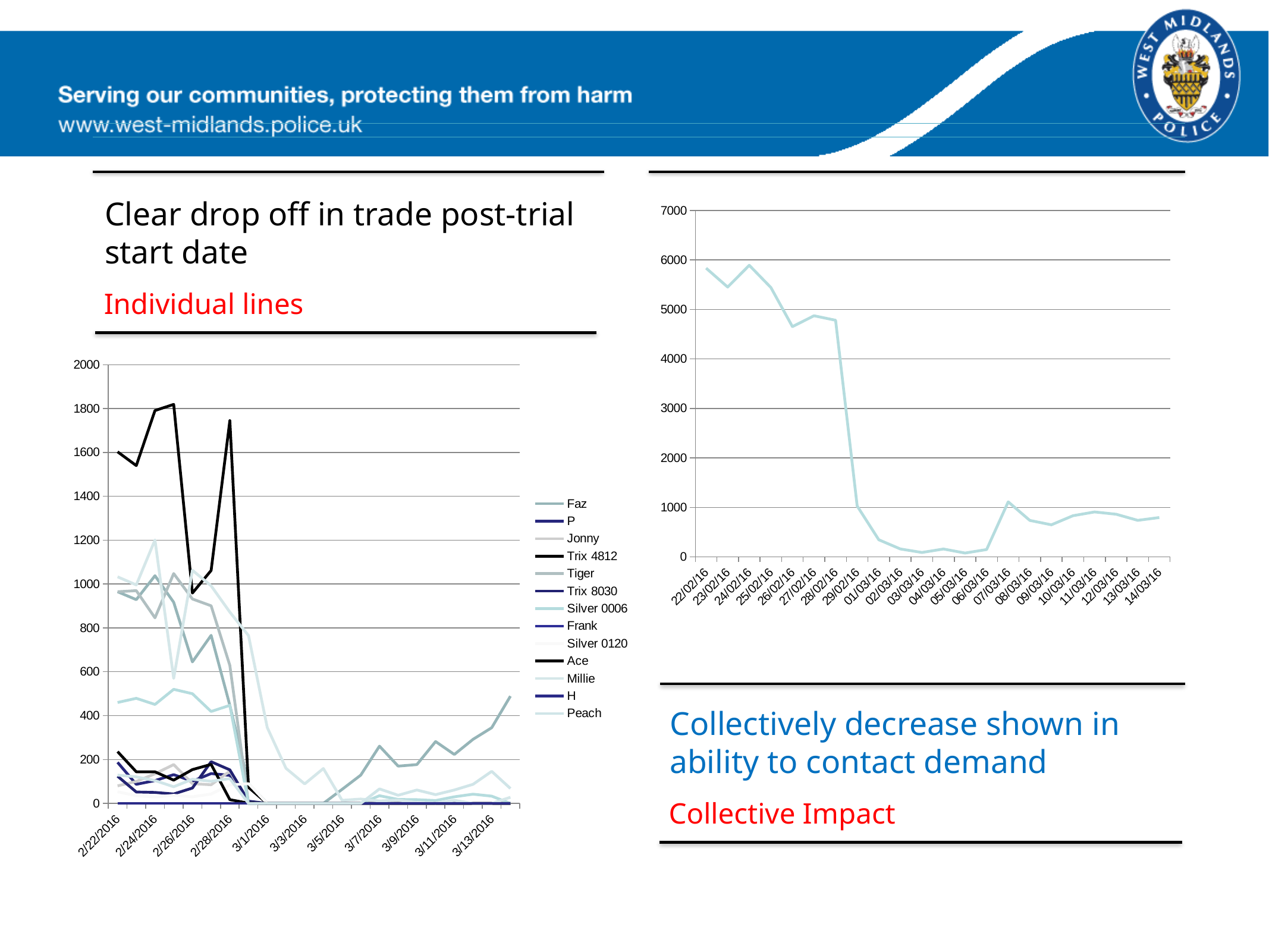
What kind of chart is the 'Collective Impact' chart on the right of the slide? line chart What kind of chart is the 'Individual lines' chart on the left of the slide? line chart In the 'Collective Impact' chart, is the value for 02/03/16 greater or less than 1000? less What is the highest value shown on the y axis of the 'Individual lines' chart? 2000 In the 'Collective Impact' chart, is the value for 04/03/16 greater or less than 1000? less In the 'Collective Impact' chart, which is larger, the value for 24/02/16 or the value for 10/03/16? 24/02/16 In the 'Collective Impact' chart, is the value for 28/02/16 greater or less than 4000? greater In the 'Collective Impact' chart, do the values overall rise or fall from 22/02/16 to 14/03/16? fall What is the first date shown on the x axis of the 'Collective Impact' chart? 22/02/16 How many series does the legend of the 'Individual lines' chart list? 13 How many dates are shown on the x axis of the 'Collective Impact' chart? 22